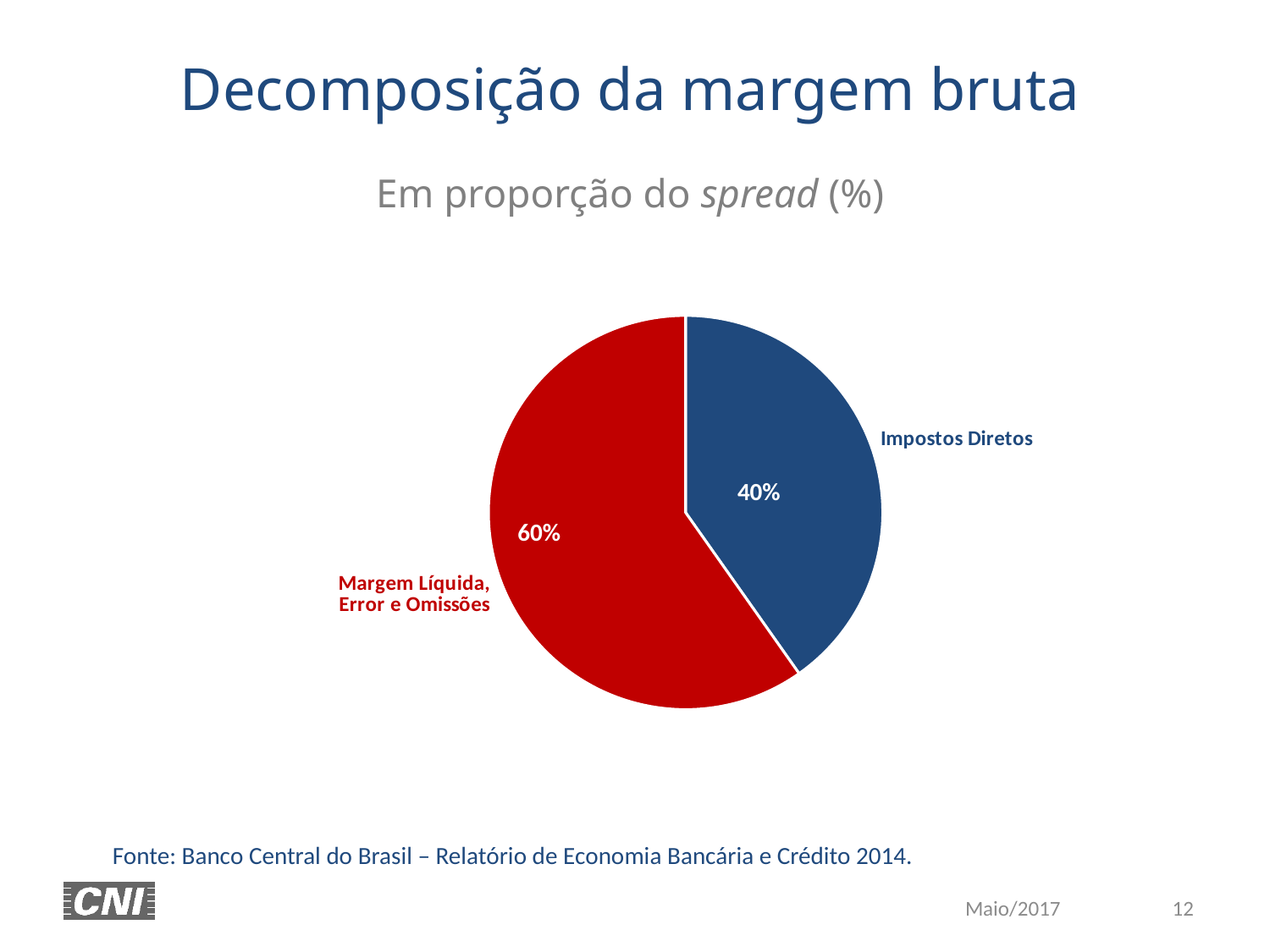
What is the difference in percentage points between Margem Líquida, Error e Omissões and Impostos Diretos? 20 percentage points Which slice is the smallest? Impostos Diretos What is the title of the chart? Decomposição da margem bruta Is the share for Impostos Diretos greater or less than 50%? less What colour is the Impostos Diretos slice? Blue What kind of chart is shown on the slide? Pie chart How many slices does the pie chart have? 2 What share of the pie does Impostos Diretos represent? 40% What share of the pie does Margem Líquida, Error e Omissões represent? 60% Which slice is the largest? Margem Líquida, Error e Omissões Which is larger, Impostos Diretos or Margem Líquida, Error e Omissões? Margem Líquida, Error e Omissões